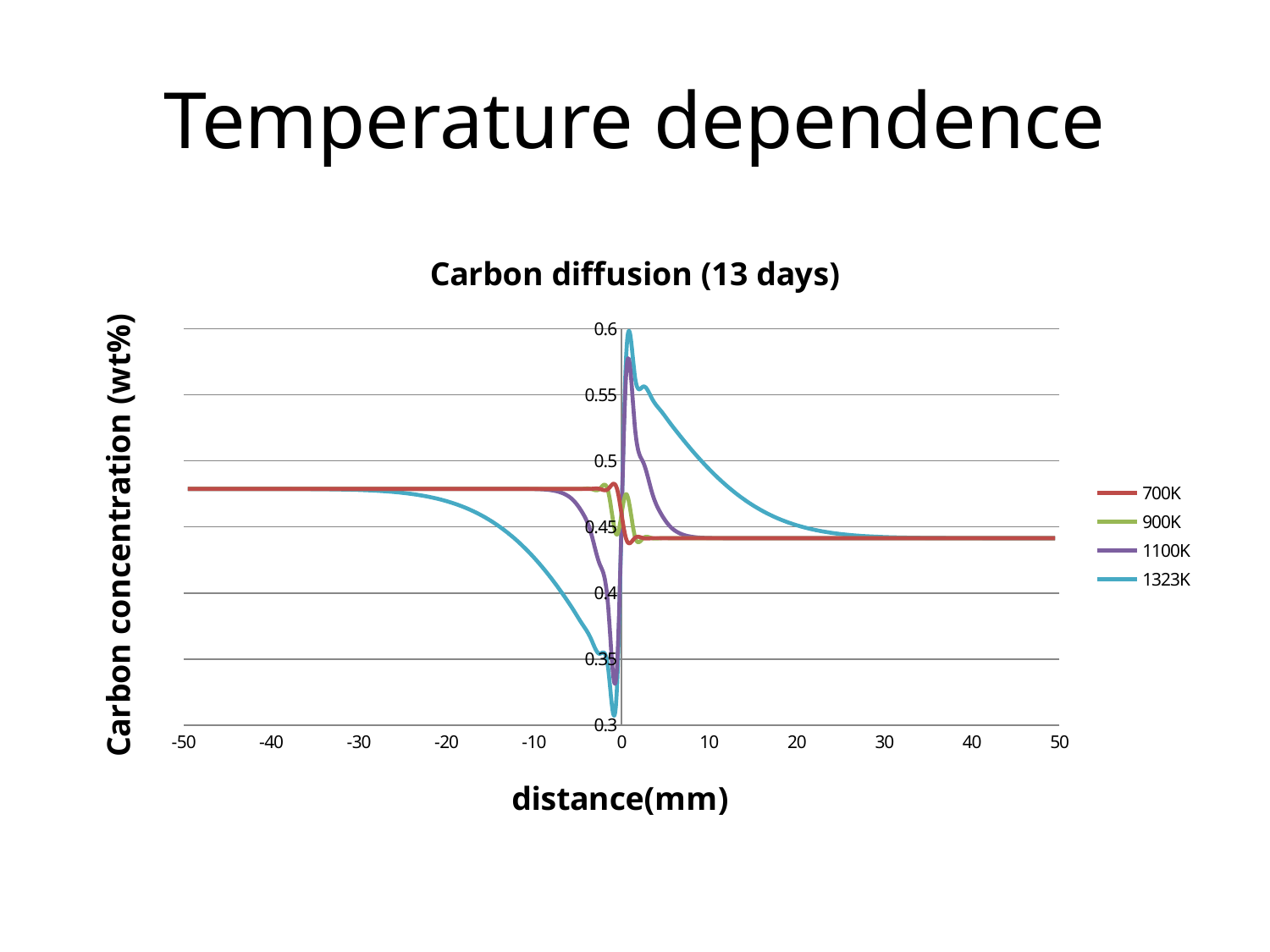
Is the minimum value of the 1100K series greater or less than 0.4? less What is the label of the x axis? distance(mm) What is the title of the chart? Carbon diffusion (13 days) Which series dips to the lowest carbon concentration on the chart? 1323K Is the minimum value of the 1323K series greater or less than 0.35? less Is the value of the 700K series at a distance of -50 mm greater or less than 0.45? greater What kind of chart is shown on the slide? line chart How many series does the legend list? 4 Which series reaches the highest carbon concentration on the chart? 1323K Which series spreads over the widest range of distances away from 0 mm, 1323K or 900K? 1323K